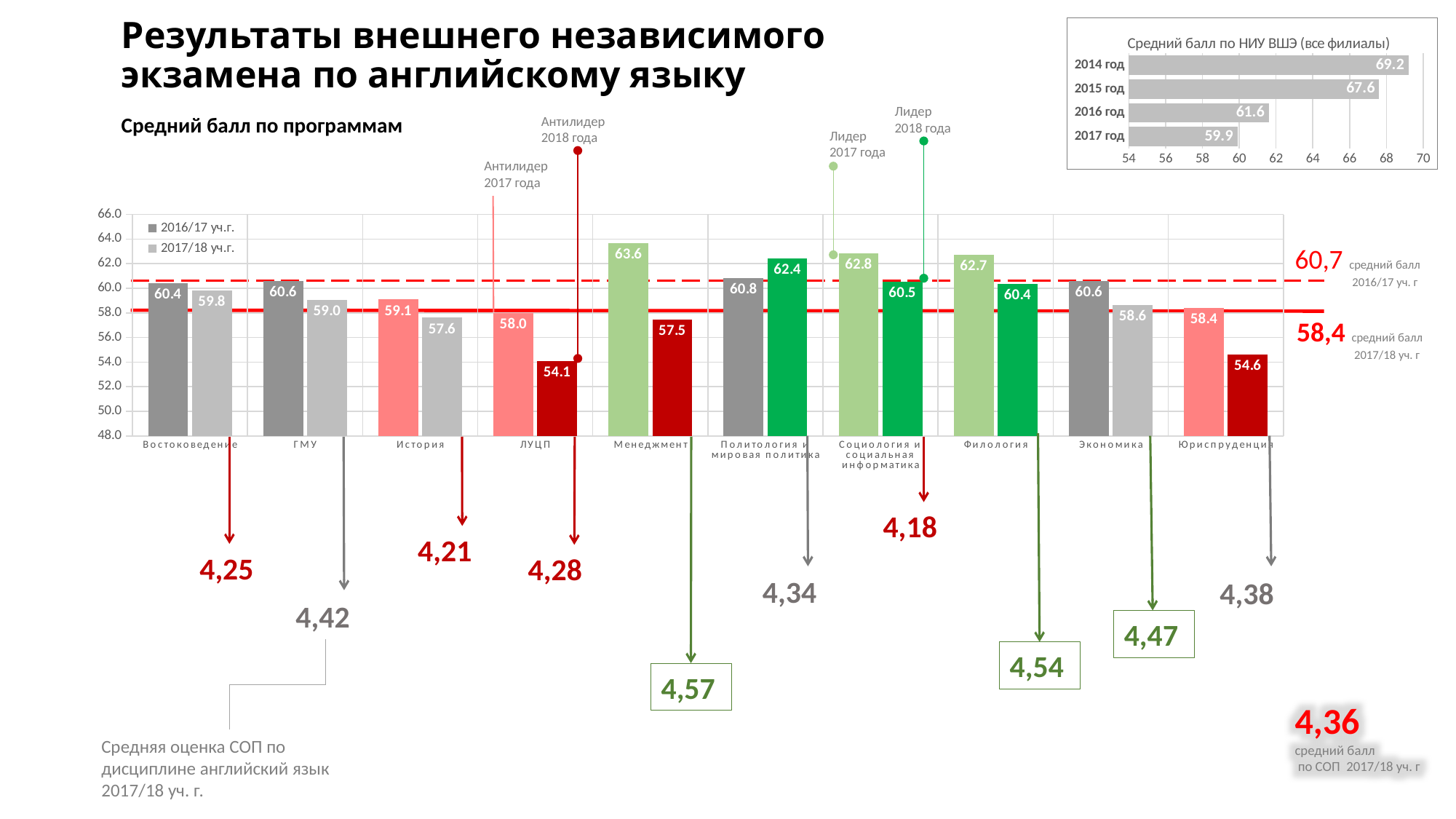
How many programs are shown on the x axis of the chart 'Средний балл по программам'? 10 In the chart 'Средний балл по программам', what is the difference between the 2016/17 and 2017/18 values for Юриспруденция? 3.8 In the chart 'Средний балл по НИУ ВШЭ (все филиалы)', what is the value for 2016 год? 61.6 In the chart 'Средний балл по НИУ ВШЭ (все филиалы)', what is the difference between the values for 2014 год and 2017 год? 9.3 In the chart 'Средний балл по программам', which program has the lowest value in the 2017/18 уч.г. series? ЛУЦП In the chart 'Средний балл по программам', what is the value for Менеджмент in the 2016/17 уч.г. series? 63.6 In the chart 'Средний балл по программам', what is the value for ЛУЦП in the 2017/18 уч.г. series? 54.1 What kind of chart is 'Средний балл по НИУ ВШЭ (все филиалы)' in the top right corner? bar chart In the chart 'Средний балл по НИУ ВШЭ (все филиалы)', do the values rise or fall from 2014 год to 2017 год? fall In the chart 'Средний балл по программам', which is larger for Политология и мировая политика: the 2016/17 уч.г. value or the 2017/18 уч.г. value? 2017/18 уч.г. In the chart 'Средний балл по программам', which program has the highest value in the 2016/17 уч.г. series? Менеджмент How many series does the legend of the chart 'Средний балл по программам' list? 2